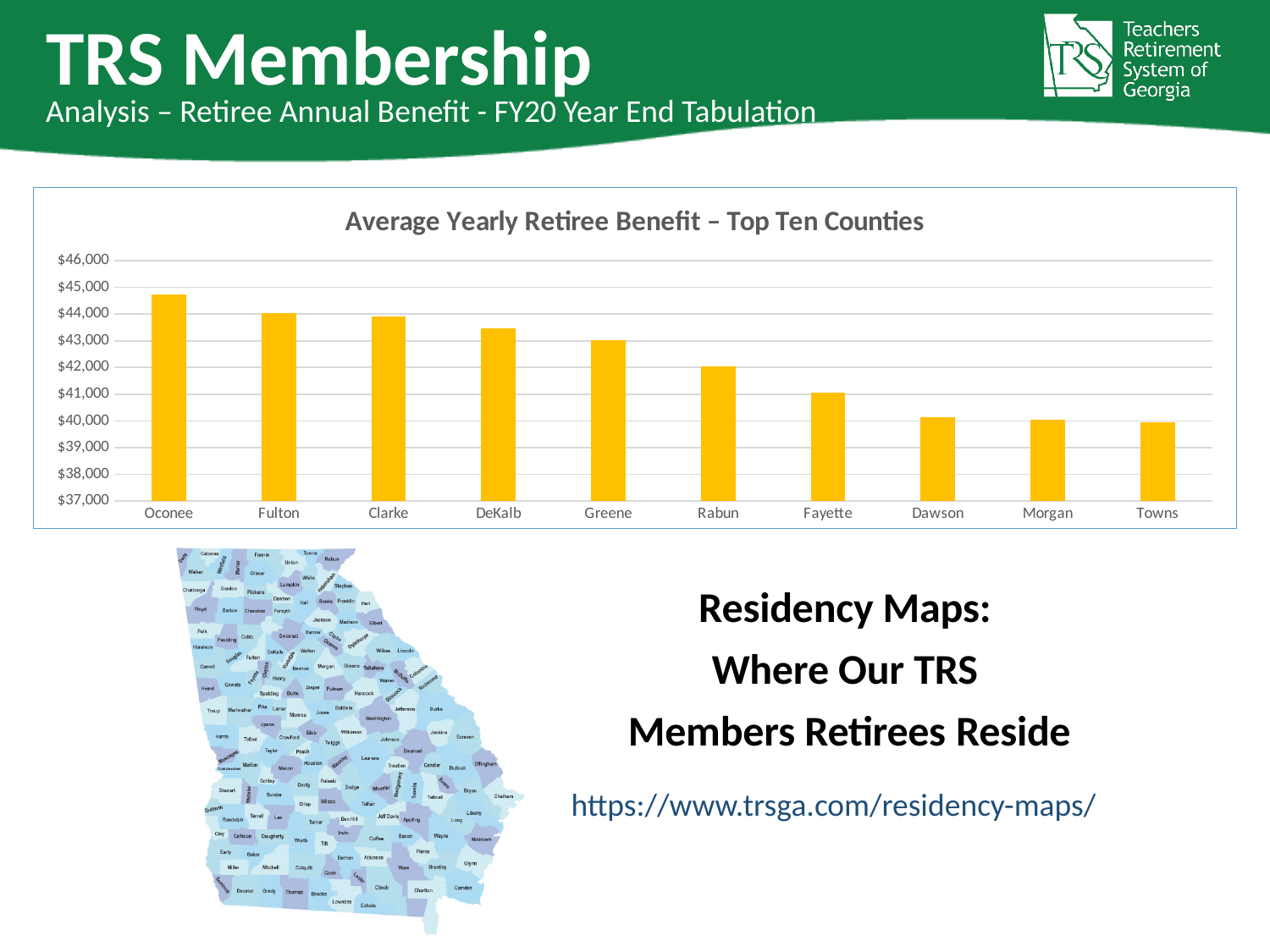
What kind of chart is shown on the slide? bar chart Is the value for Oconee greater or less than $44,000? greater Is the value for Greene greater or less than $44,000? less What is the title of the chart? Average Yearly Retiree Benefit – Top Ten Counties Is the value for DeKalb greater or less than $43,000? greater Which county has the larger average yearly retiree benefit, Greene or Fayette? Greene Which county has the larger average yearly retiree benefit, Oconee or Rabun? Oconee Do the values rise or fall moving from left to right along the x axis? fall Which county has the highest average yearly retiree benefit? Oconee How many counties are shown in the chart? 10